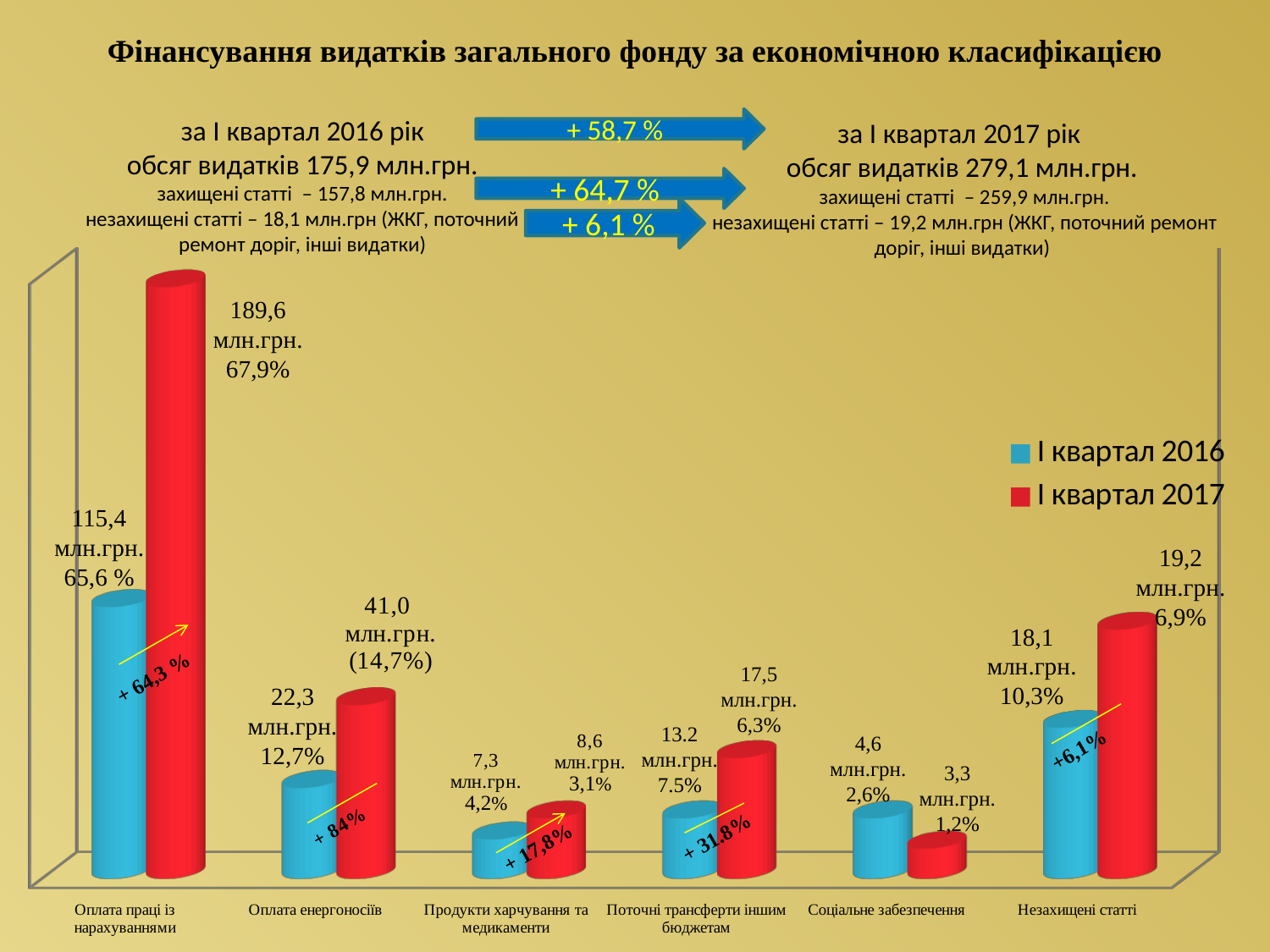
What percentage share is shown for Незахищені статті in І квартал 2016? 10,3% What kind of chart is shown on the slide? Bar chart How many categories are shown on the x axis of the chart? 6 Which category has the lowest value in І квартал 2016? Соціальне забезпечення What is the value for Соціальне забезпечення in І квартал 2017? 3,3 млн.грн. What is the difference between the І квартал 2017 and І квартал 2016 values for Оплата праці із нарахуваннями? 74,2 млн.грн. Which category has the highest value in І квартал 2017? Оплата праці із нарахуваннями How many series does the legend list? 2 What is the difference between the І квартал 2017 and І квартал 2016 values for Оплата енергоносіїв? 18,7 млн.грн. For Соціальне забезпечення, which is larger: the І квартал 2016 value or the І квартал 2017 value? І квартал 2016 What is the value for Оплата праці із нарахуваннями in І квартал 2017? 189,6 млн.грн. What is the value for Оплата енергоносіїв in І квартал 2016? 22,3 млн.грн.